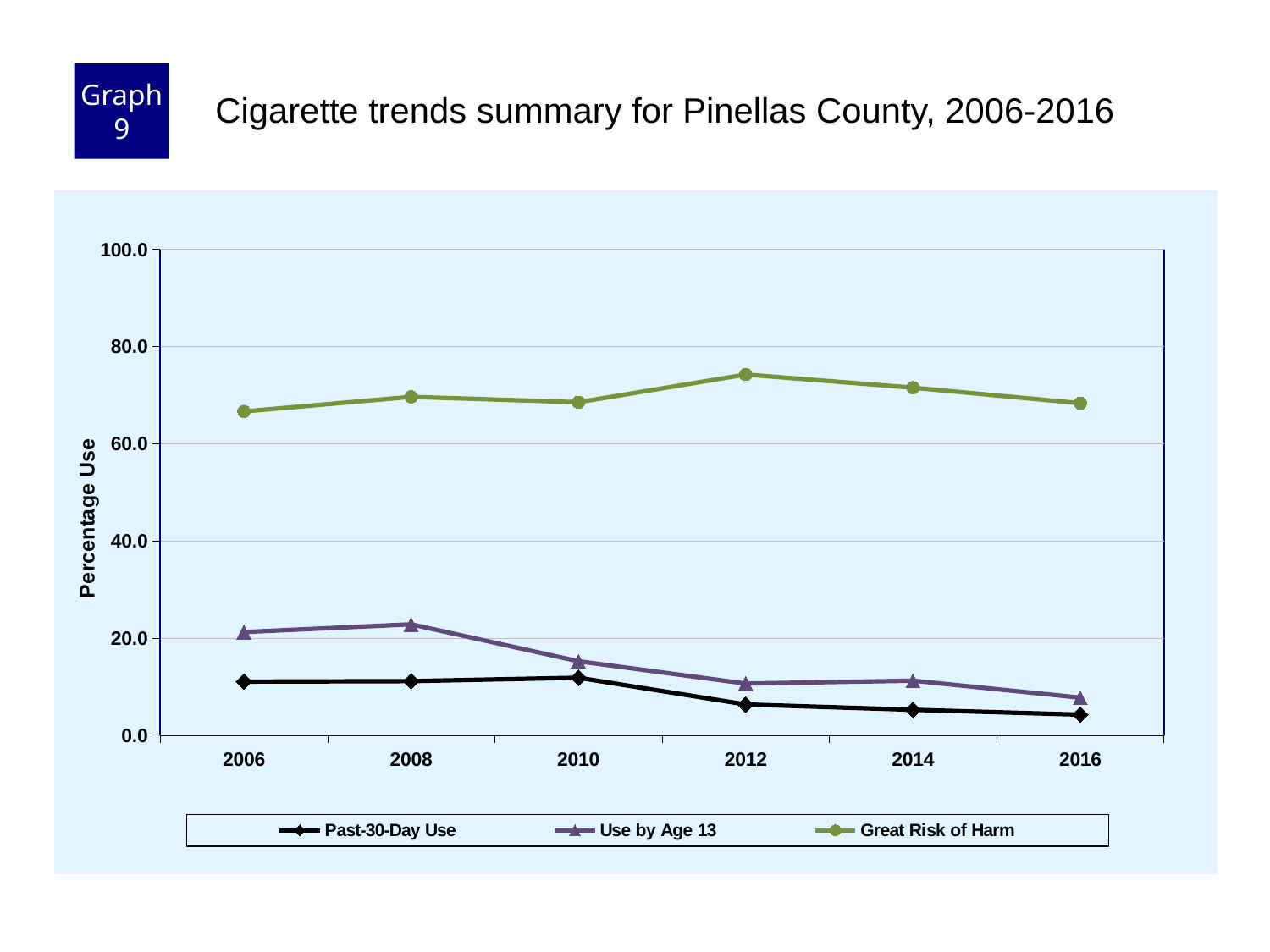
Does the Past-30-Day Use series rise or fall from 2010 to 2016? fall Is the value for Use by Age 13 in 2008 greater or less than 20? greater Is the value for Great Risk of Harm in 2012 greater or less than 80? less What is the title of the y axis? Percentage Use Is the value for Past-30-Day Use in 2012 greater or less than 20? less How many years are plotted along the x axis? 6 In which year is the Use by Age 13 series at its lowest? 2016 In 2006, which is larger: Use by Age 13 or Past-30-Day Use? Use by Age 13 In which year is the Great Risk of Harm series at its highest? 2012 What kind of chart is shown on the slide? Line chart How many series does the legend list? 3